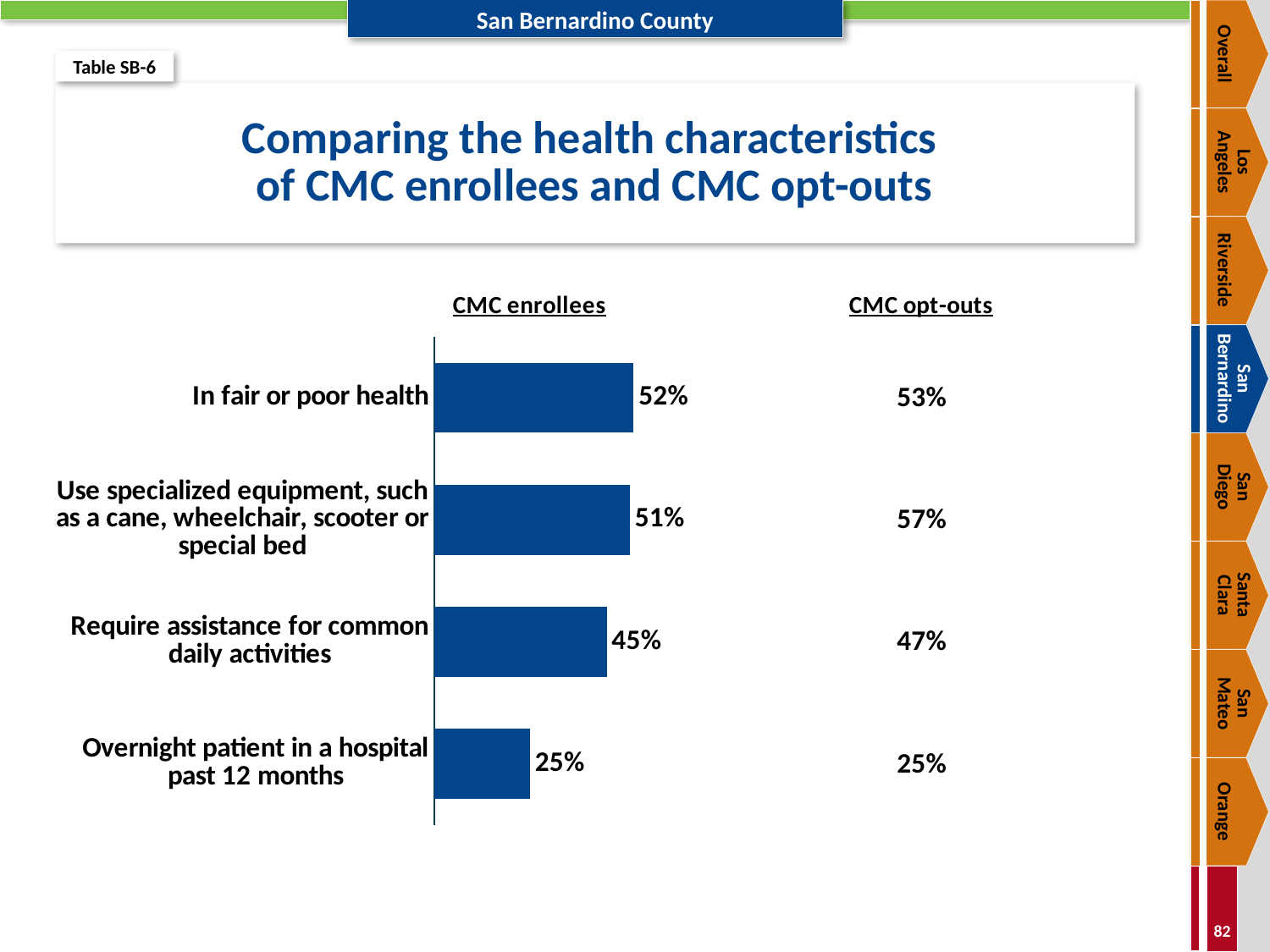
Which health characteristic has the highest percentage among CMC enrollees? In fair or poor health What is the title of the chart? Comparing the health characteristics of CMC enrollees and CMC opt-outs Which health characteristic has the lowest percentage among CMC enrollees? Overnight patient in a hospital past 12 months What is the table label shown at the top left of the slide? Table SB-6 What type of chart is used to show the CMC enrollees values? Bar chart What percentage of CMC opt-outs use specialized equipment, such as a cane, wheelchair, scooter or special bed? 57% What percentage of CMC enrollees require assistance for common daily activities? 45% How many health characteristics are compared in the chart? 4 What percentage of CMC opt-outs were an overnight patient in a hospital in the past 12 months? 25% What percentage of CMC enrollees are in fair or poor health? 52% What is the difference between the CMC opt-outs and CMC enrollees percentages for using specialized equipment? 6% For requiring assistance for common daily activities, which group has the higher percentage, CMC enrollees or CMC opt-outs? CMC opt-outs